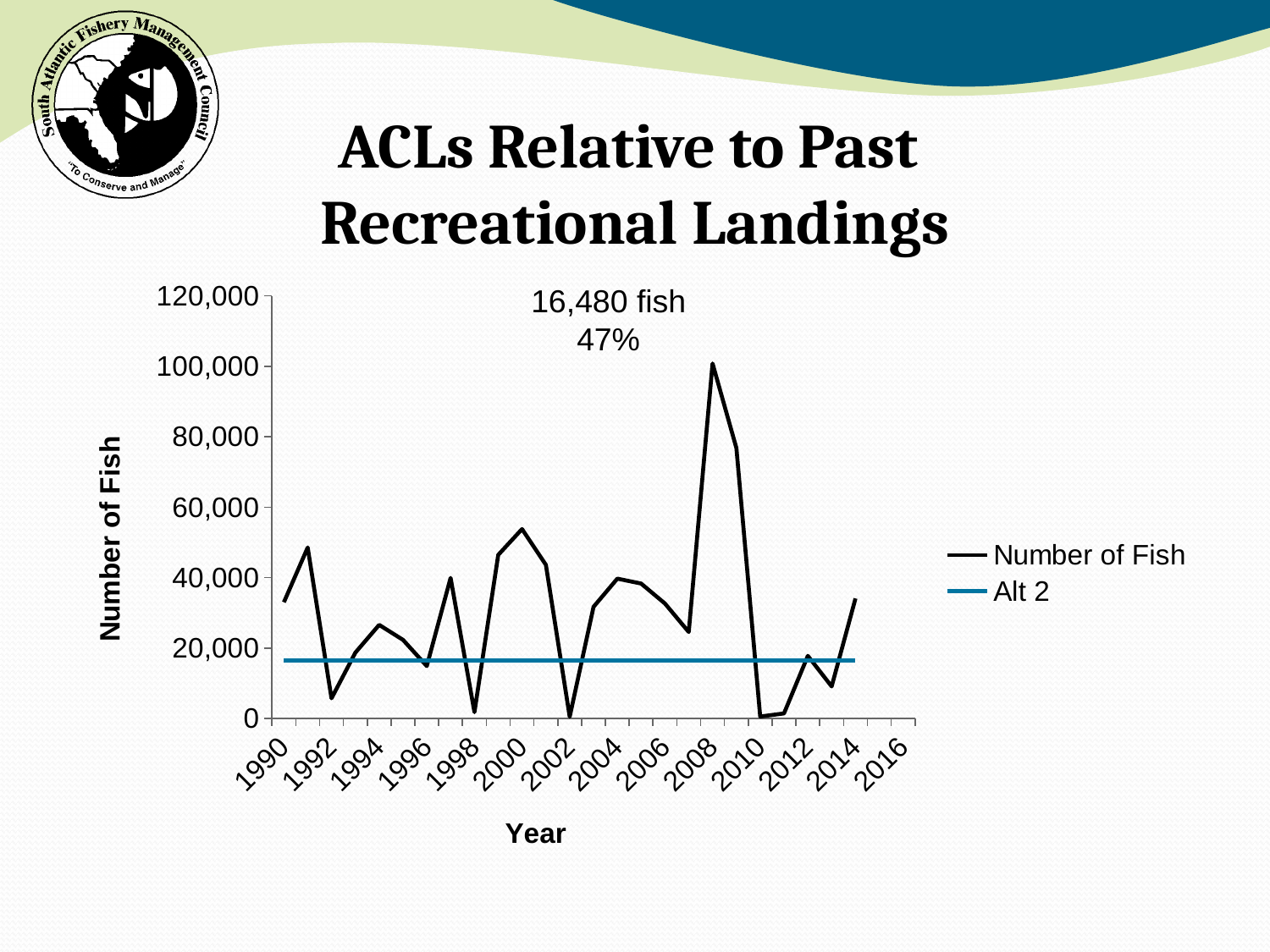
Which year has the larger Number of Fish value, 2001 or 2010? 2001 What value in fish is given for the Alt 2 line in the chart annotation? 16,480 fish Which year has the larger Number of Fish value, 1990 or 2009? 2009 Is the Number of Fish value for 2001 greater or less than 40,000? greater Is the Alt 2 line greater or less than 20,000? less Is the Number of Fish value for 2010 greater or less than 20,000? less In which year does the Number of Fish series reach its highest value? 2008 How many series does the legend list? 2 What type of chart is shown on the slide? line chart What percentage is shown in the annotation above the chart? 47% What are the two series named in the legend? Number of Fish and Alt 2